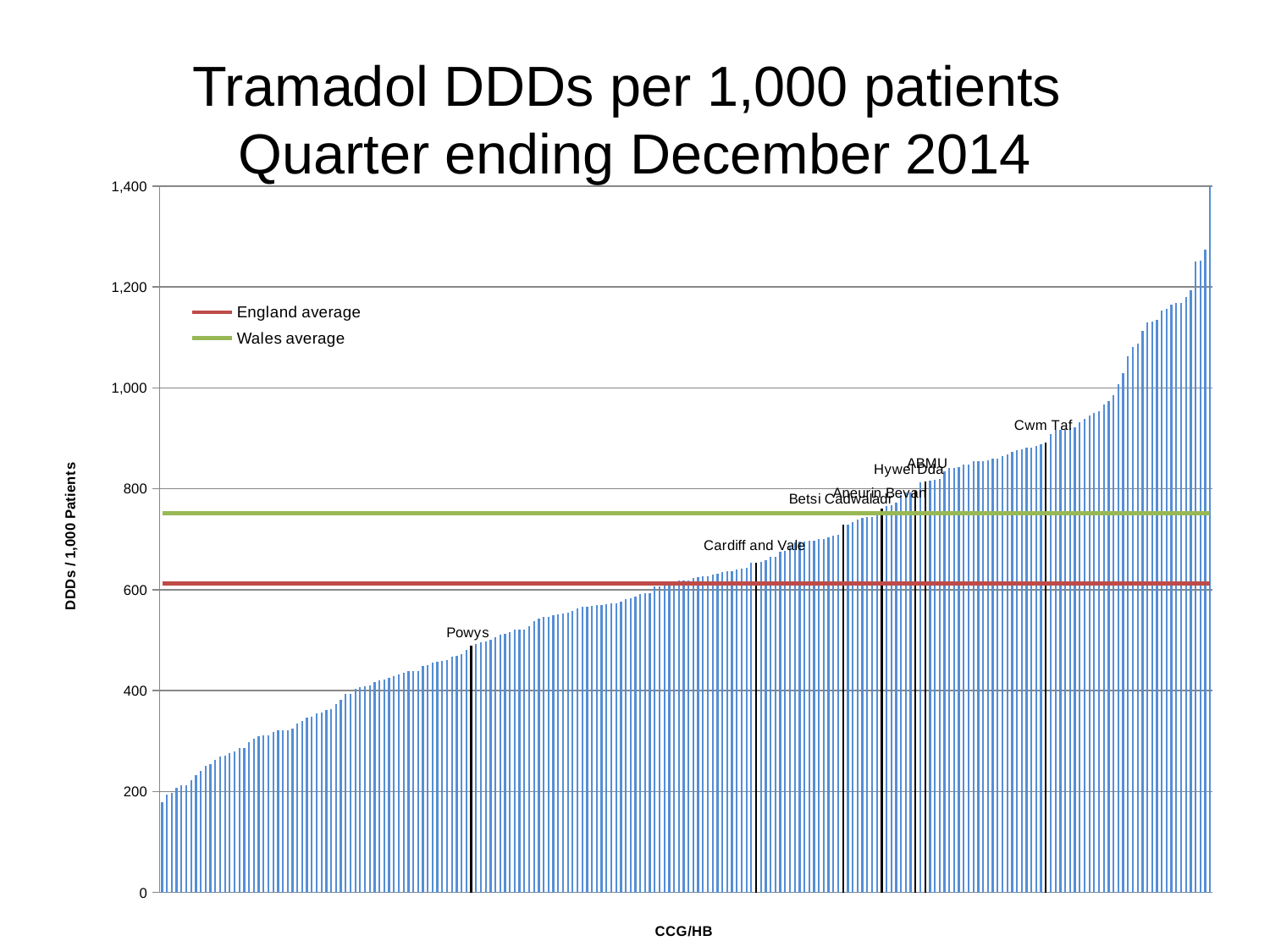
How many entries does the legend list? 2 Do the bar values rise or fall from left to right along the x axis? rise Which is larger, the value for Powys or the value for Cwm Taf? Cwm Taf Which of the labelled health boards has the lowest value? Powys What kind of chart is shown on the slide? bar chart Is the value for Cwm Taf greater or less than 800? greater Is the value for Powys greater or less than 600? less What is the title of the y axis? DDDs / 1,000 Patients Is the Wales average line greater or less than 700? greater Which of the labelled health boards has the highest value? Cwm Taf Which is higher, the England average line or the Wales average line? Wales average